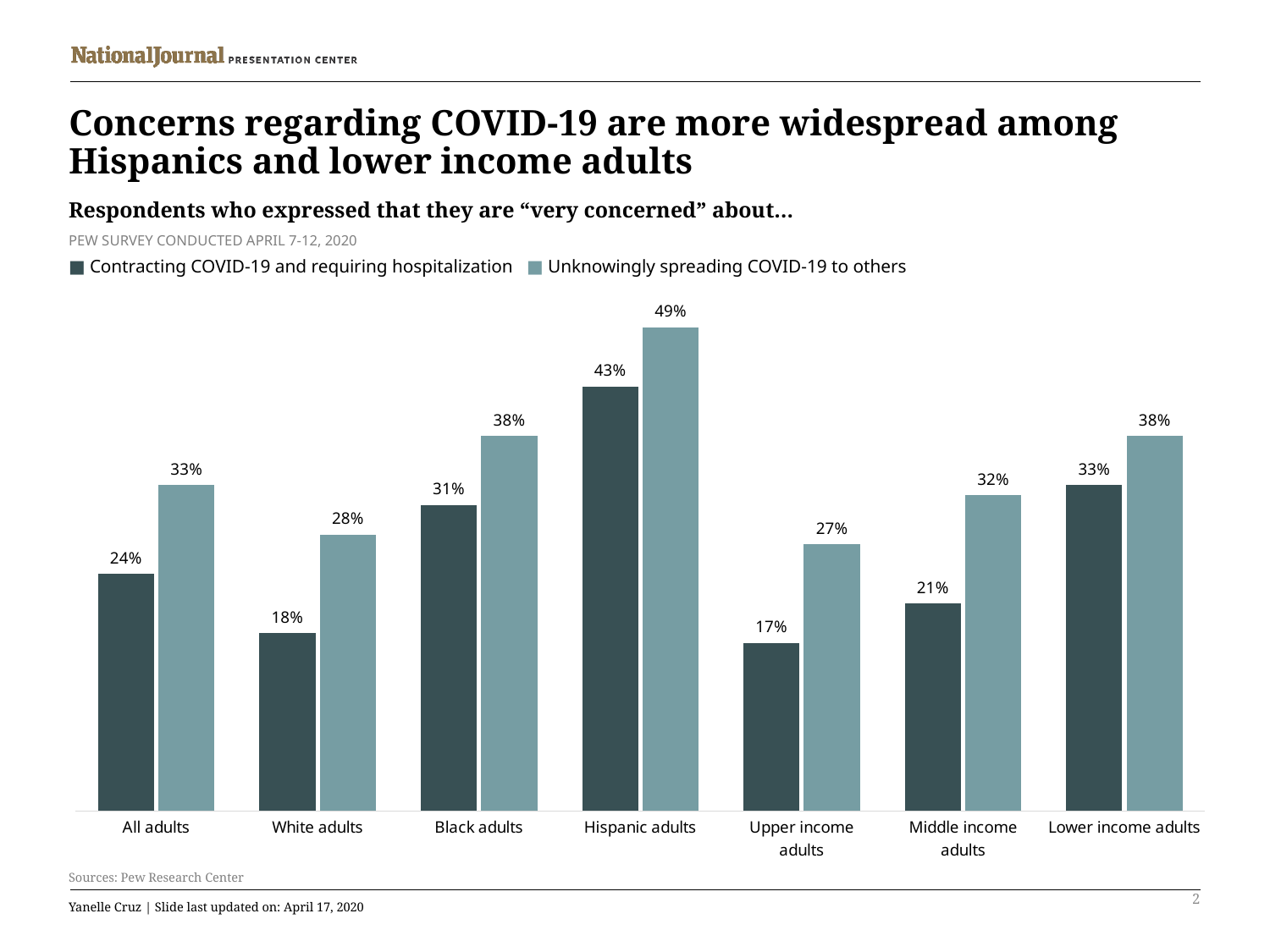
Which category has the highest value for contracting COVID-19 and requiring hospitalization? Hispanic adults What percentage of Hispanic adults are very concerned about unknowingly spreading COVID-19 to others? 49% What kind of chart is shown on the slide? Bar chart Which category has the lowest value for contracting COVID-19 and requiring hospitalization? Upper income adults What is the value for Upper income adults in the 'Unknowingly spreading COVID-19 to others' series? 27% What percentage of White adults are very concerned about contracting COVID-19 and requiring hospitalization? 18% What is the difference between the two series for Black adults? 7% How many categories are shown on the x axis? 7 What is the difference between Hispanic adults and All adults for unknowingly spreading COVID-19 to others? 16% How many series does the legend list? 2 Which is larger: the hospitalization value for Lower income adults or for Middle income adults? Lower income adults Which survey organization is cited as the source of the data? Pew Research Center